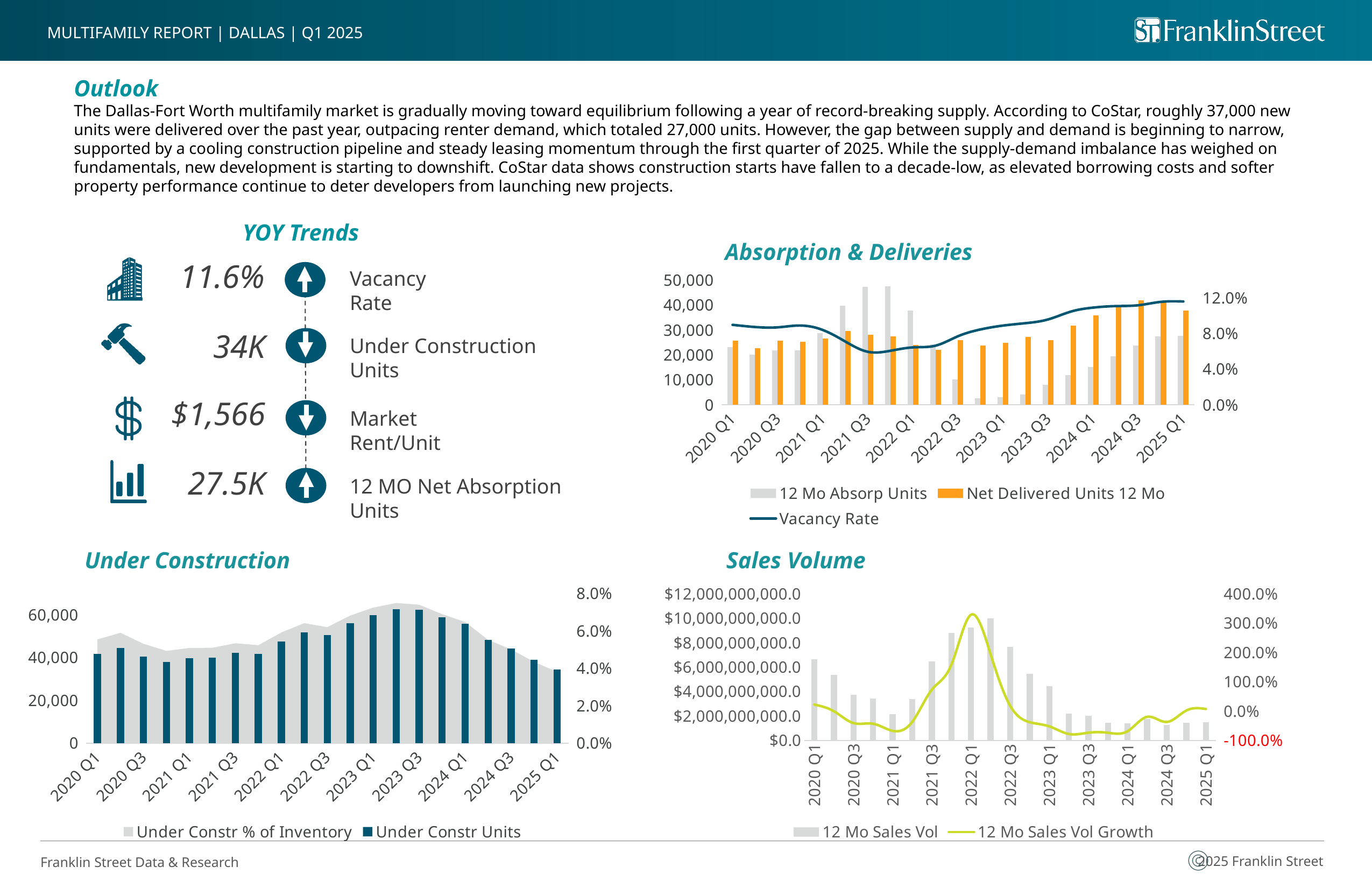
On the Under Construction chart, which quarter has the lowest Under Constr Units? 2025 Q1 On the Absorption & Deliveries chart, does the Vacancy Rate line rise or fall from 2022 Q1 to 2025 Q1? rise On the Under Construction chart, how many series does the legend list? 2 What kind of chart is the Sales Volume chart? Combination bar and line chart On the Sales Volume chart, is the value for 12 Mo Sales Vol in 2022 Q1 greater or less than $8,000,000,000.0? greater On the Absorption & Deliveries chart, how many series does the legend list? 3 On the Absorption & Deliveries chart, in 2021 Q3, which is larger: 12 Mo Absorp Units or Net Delivered Units 12 Mo? 12 Mo Absorp Units On the Under Construction chart, do the Under Constr Units rise or fall from 2023 Q3 to 2025 Q1? fall On the Absorption & Deliveries chart, what colour are the Net Delivered Units 12 Mo bars? Orange On the Absorption & Deliveries chart, is the value for 12 Mo Absorp Units in 2021 Q3 greater or less than 40,000? greater On the Absorption & Deliveries chart, is the value for Net Delivered Units 12 Mo in 2025 Q1 greater or less than 30,000? greater